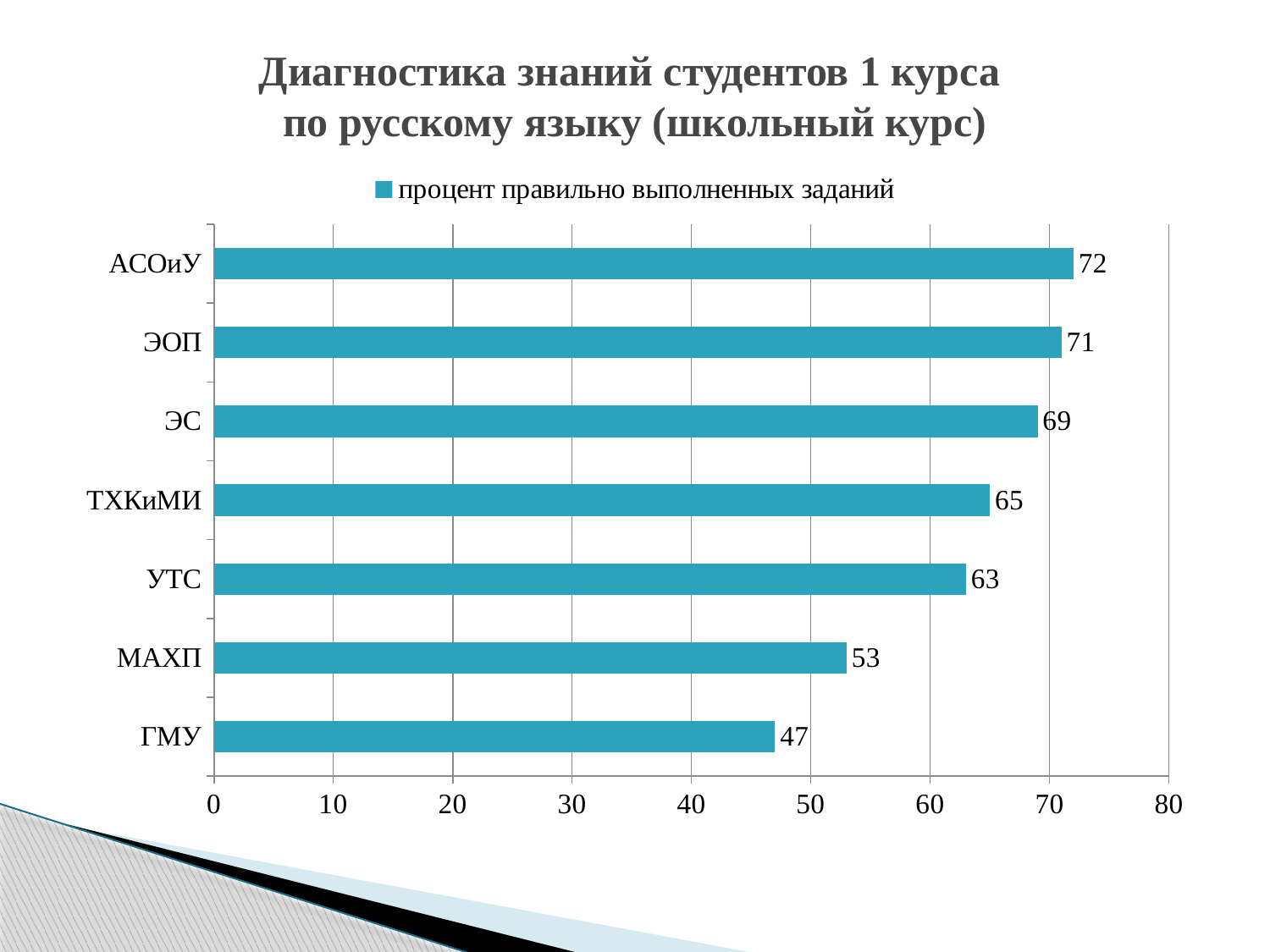
What is the value for ГМУ? 47 Is the value for МАХП greater or less than 60? less What is the value for ТХКиМИ? 65 Which category has the highest value? АСОиУ What is the difference between the values for АСОиУ and ГМУ? 25 How many categories are shown in the chart? 7 Which is larger, the value for ЭС or the value for УТС? ЭС What is the value for АСОиУ? 72 Which category has the lowest value? ГМУ What is the difference between the values for УТС and МАХП? 10 What kind of chart is shown on the slide? bar chart How many series does the legend list? 1